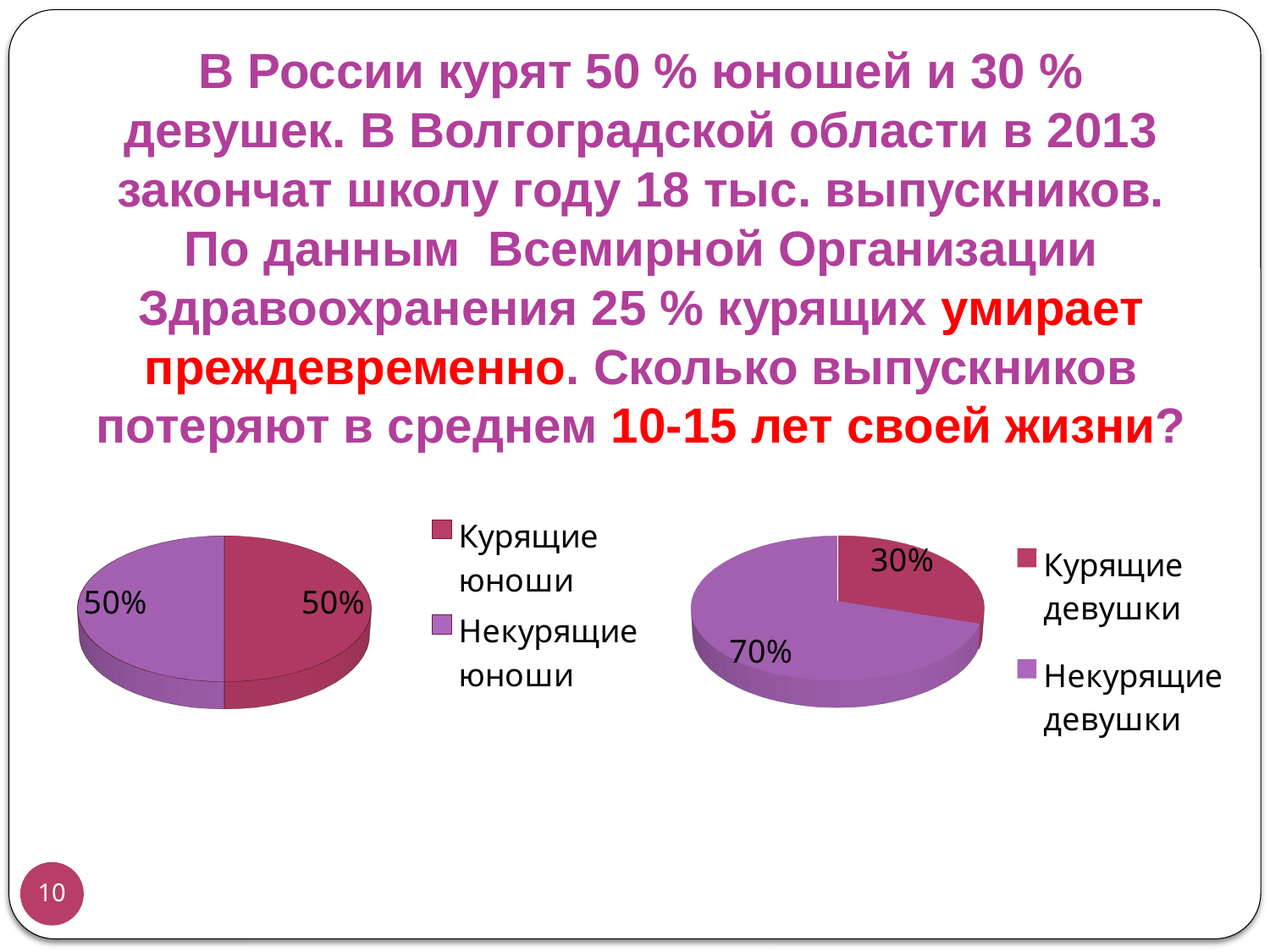
In the right pie chart, what share is labelled for Курящие девушки? 30% In the right pie chart, which slice is the largest? Некурящие девушки In the right pie chart, what share is labelled for Некурящие девушки? 70% In the right pie chart, what is the difference between the shares for Некурящие девушки and Курящие девушки? 40% In the left pie chart, what share is labelled for Курящие юноши? 50% How many slices does the right pie chart have? 2 How many entries does the legend of the left pie chart list? 2 In the right pie chart, which is larger: Курящие девушки or Некурящие девушки? Некурящие девушки In the left pie chart, what colour is the slice for Курящие юноши? Dark pink (magenta) What kind of chart is the left chart? Pie chart In the left pie chart, what share is labelled for Некурящие юноши? 50% In the right pie chart, which slice is the smallest? Курящие девушки